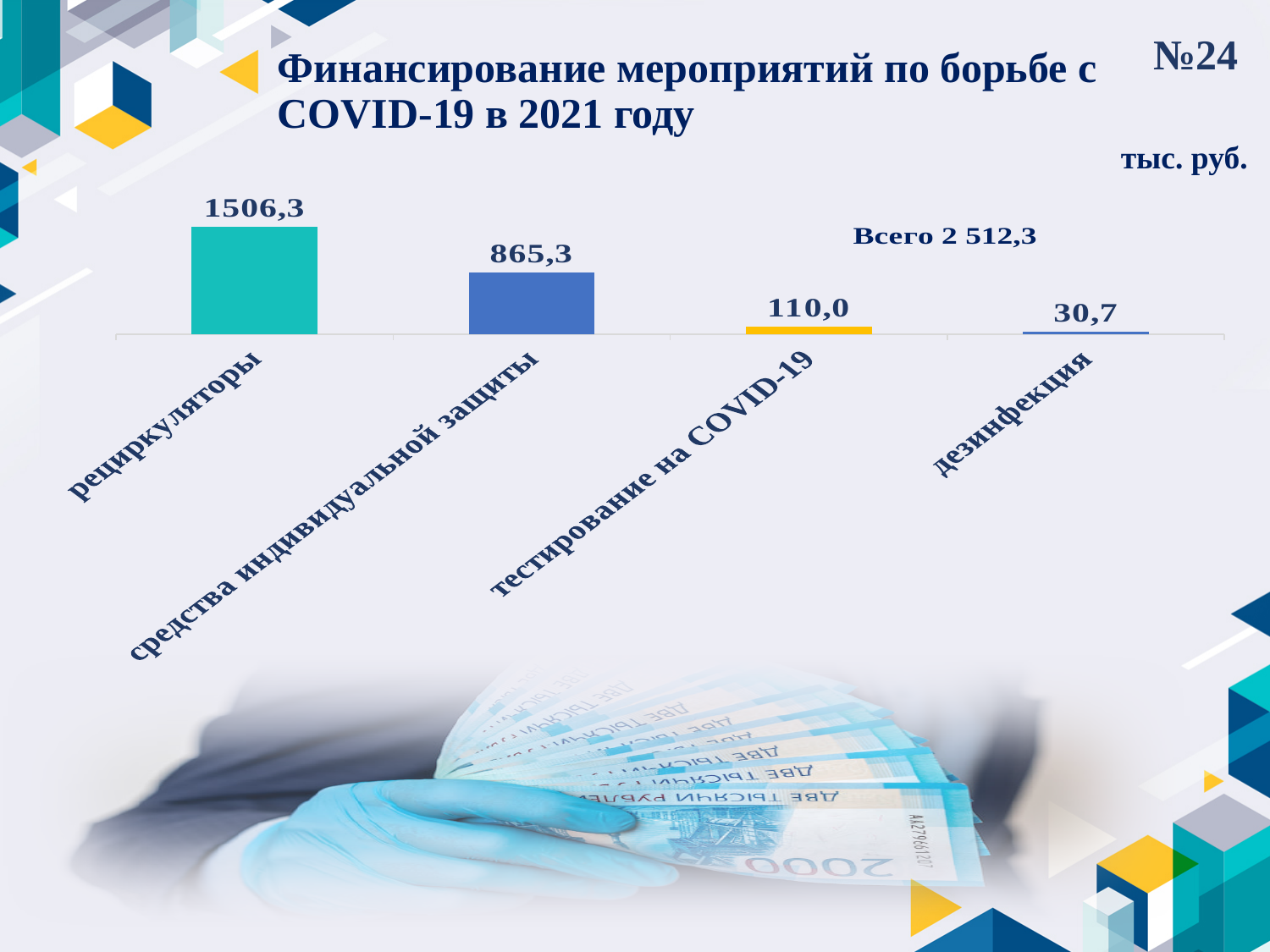
What is the difference between the values for рециркуляторы and средства индивидуальной защиты? 641,0 Which category has the lowest value? дезинфекция How many categories are shown in the chart? 4 What is the value for рециркуляторы? 1506,3 Which category has the highest value? рециркуляторы What total (Всего) is printed on the chart? 2 512,3 What kind of chart is shown on the slide? bar chart What is the value for тестирование на COVID-19? 110,0 What is the difference between the values for тестирование на COVID-19 and дезинфекция? 79,3 What is the value for средства индивидуальной защиты? 865,3 What is the value for дезинфекция? 30,7 Which is larger, the value for средства индивидуальной защиты or the value for тестирование на COVID-19? средства индивидуальной защиты